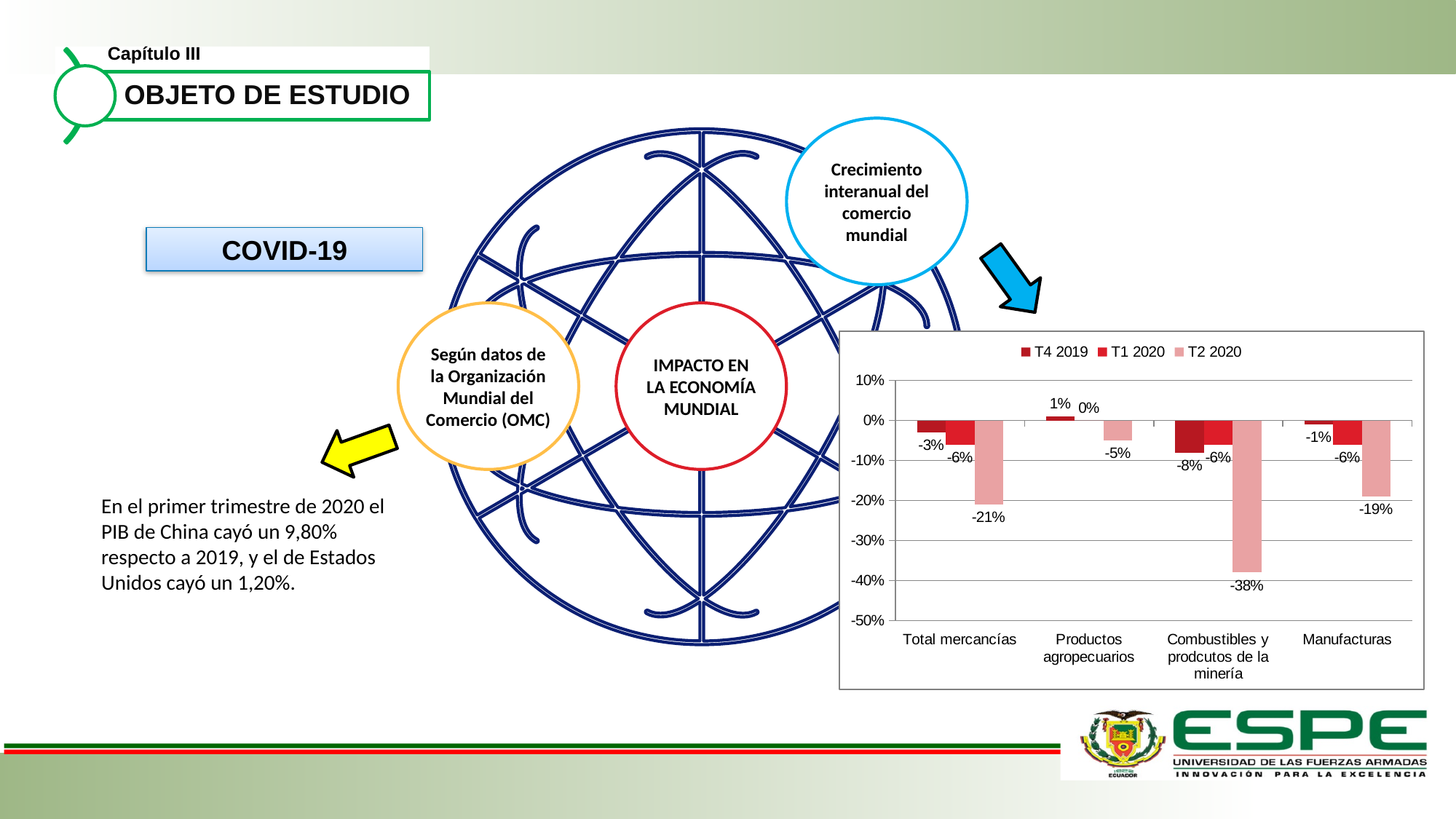
Which category has the highest T4 2019 value? Productos agropecuarios How many categories are shown on the x axis of the chart? 4 What is the T4 2019 value for Manufacturas? -1% What type of chart is shown on the slide? bar chart Which series is shown in the lightest pink colour in the chart legend? T2 2020 What is the difference between the T2 2020 values for Total mercancías and Manufacturas? 2% What is the T4 2019 value for Productos agropecuarios? 1% Which is larger, the T4 2019 value for Total mercancías or the T4 2019 value for Combustibles y prodcutos de la minería? Total mercancías Which category has the lowest T2 2020 value? Combustibles y prodcutos de la minería How many series does the chart legend list? 3 What is the T2 2020 value for Total mercancías? -21% What is the T2 2020 value for Combustibles y prodcutos de la minería? -38%